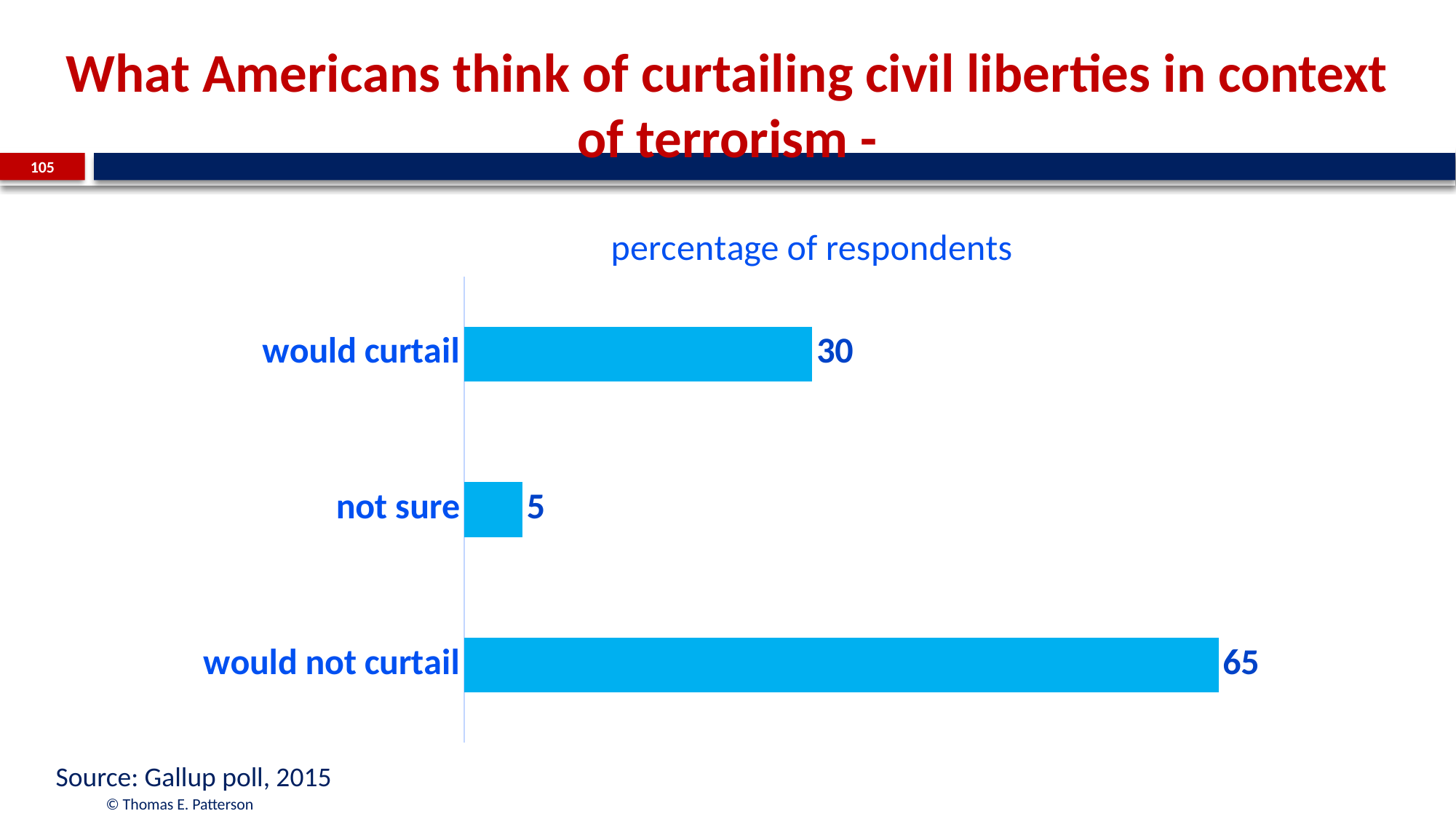
What is the value for "would curtail"? 30 What kind of chart is shown on the slide? bar chart What is the value for "would not curtail"? 65 Which is larger, the value for "would curtail" or the value for "would not curtail"? would not curtail What is the title of the chart? percentage of respondents What is the value for "not sure"? 5 What is the difference between the values for "would curtail" and "not sure"? 25 Which category has the lowest value? not sure How many categories are shown in the chart? 3 What is the difference between the values for "would not curtail" and "would curtail"? 35 Which category has the highest value? would not curtail What is the source cited for the chart data? Gallup poll, 2015